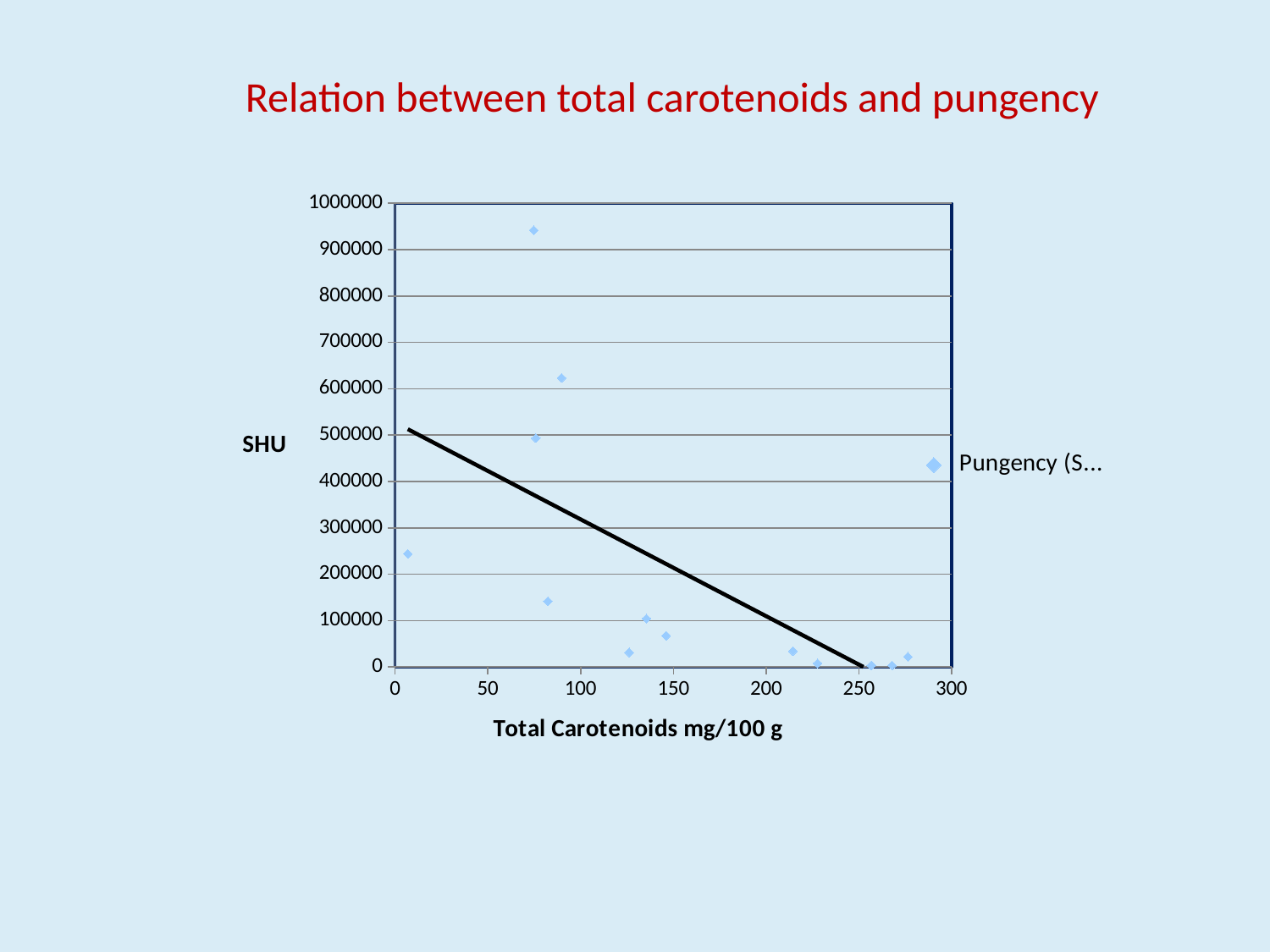
Are the SHU values of the points beyond 200 mg/100 g greater or less than 100000? less What is the label of the y axis? SHU Does the trend line rise or fall as total carotenoids increase? fall What is the label of the x axis? Total Carotenoids mg/100 g What kind of chart is shown on the slide? scatter chart Is the SHU value of the point closest to 0 mg/100 g greater or less than 200000? greater Is the highest SHU value plotted greater or less than 900000? greater How many data series does the legend list? 1 What is the maximum value shown on the y axis? 1000000 Which has the higher SHU value: the point at about 75 mg/100 g near the top of the chart or the point at about 90 mg/100 g? the point at about 75 mg/100 g